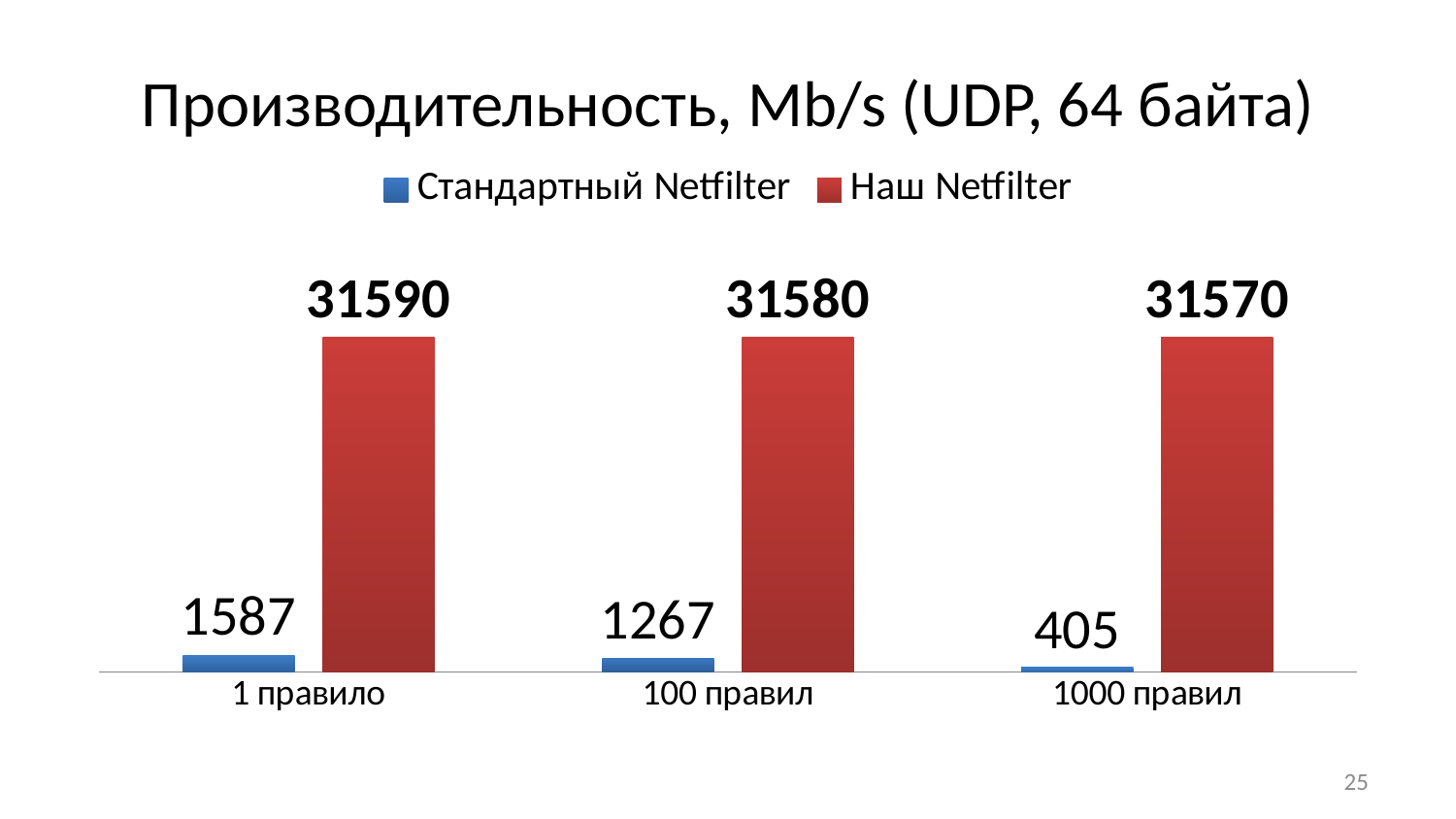
Which is larger at 100 правил: Стандартный Netfilter or Наш Netfilter? Наш Netfilter What is the difference between Наш Netfilter and Стандартный Netfilter at 1 правило? 30003 Which category has the highest value for Наш Netfilter? 1 правило How many series does the legend list? 2 What is the value for Стандартный Netfilter at 1 правило? 1587 What kind of chart is shown on the slide? Bar chart What is the value for Наш Netfilter at 1000 правил? 31570 What is the value for Стандартный Netfilter at 1000 правил? 405 What is the value for Наш Netfilter at 100 правил? 31580 Which category has the lowest value for Стандартный Netfilter? 1000 правил How many categories are shown on the x axis? 3 What is the difference between the Стандартный Netfilter values at 1 правило and 1000 правил? 1182